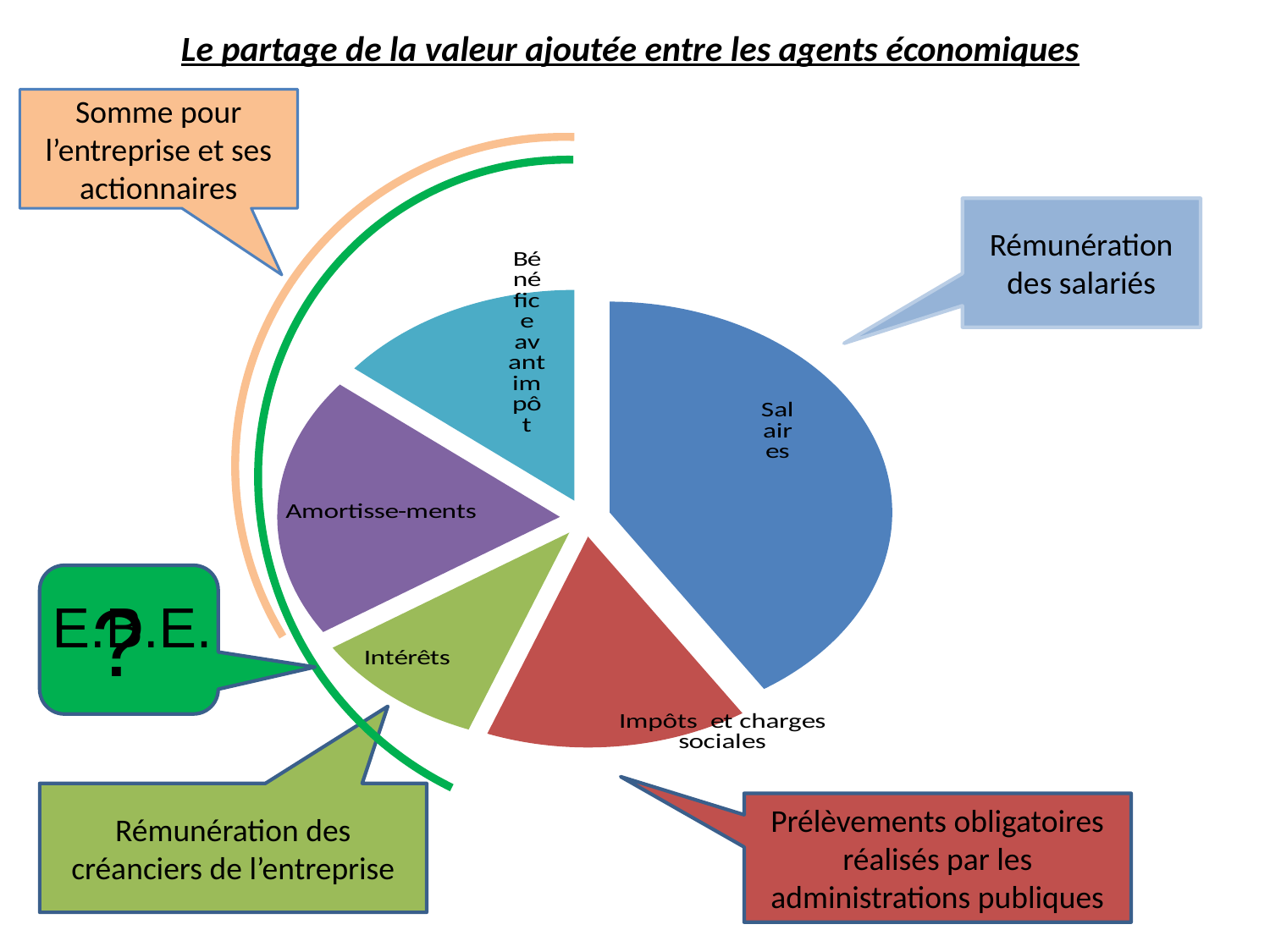
Which is larger in the pie chart, Amortissements or Intérêts? Amortissements What colour is the Salaires slice of the pie chart? blue What is the title of the slide containing the pie chart? Le partage de la valeur ajoutée entre les agents économiques What kind of chart is shown on the slide? pie chart How many slices does the pie chart have? 5 Which is larger in the pie chart, Salaires or Amortissements? Salaires Which is larger in the pie chart, Salaires or Impôts et charges sociales? Salaires Which slice of the pie chart is the largest? Salaires